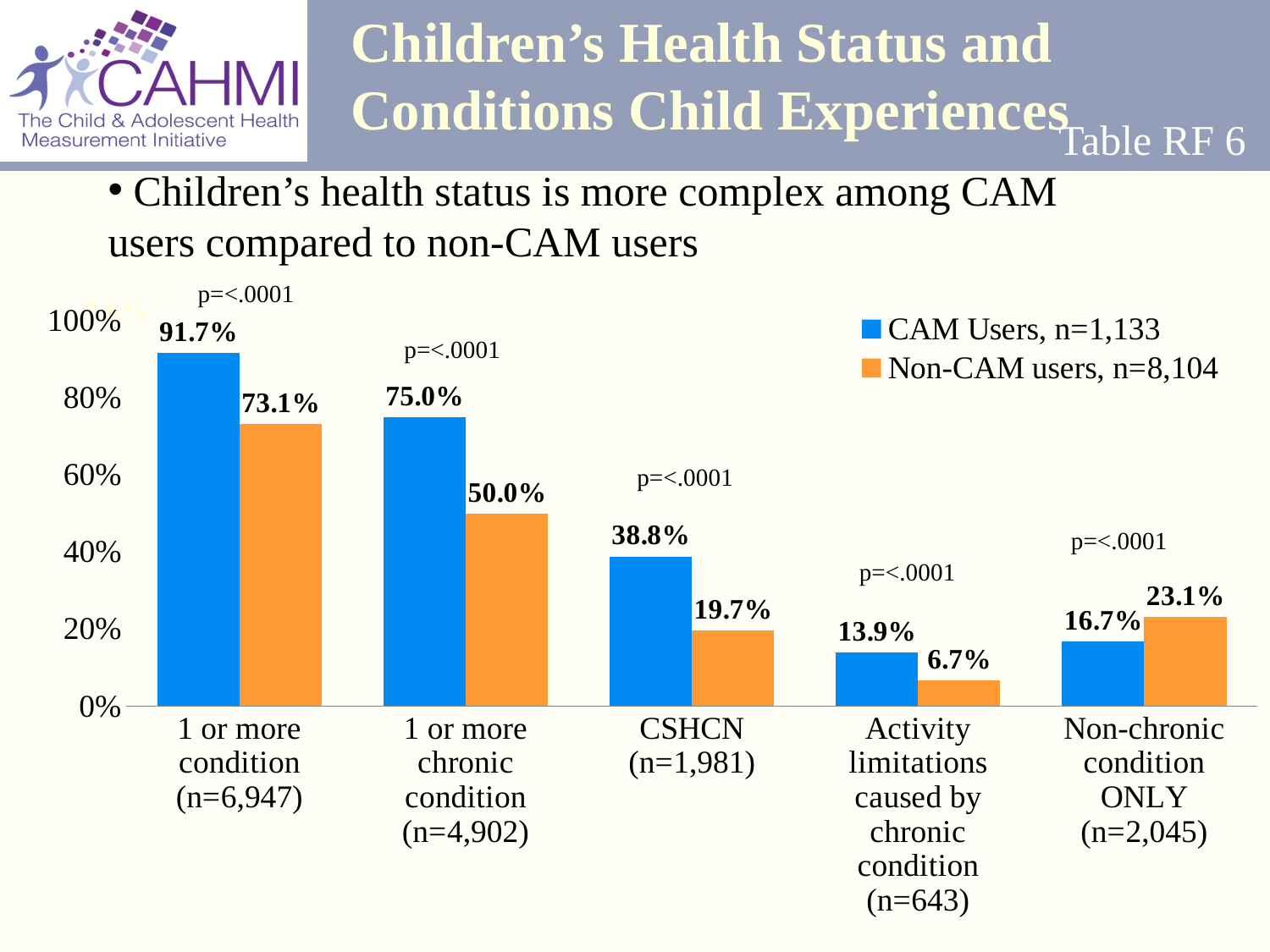
What kind of chart is shown on the slide? bar chart What is the value for CAM Users in the '1 or more condition (n=6,947)' category? 91.7% How many categories are shown on the x axis? 5 How many series does the legend list? 2 What is the value for Non-CAM users in the 'CSHCN (n=1,981)' category? 19.7% Which category has the highest value for CAM Users? 1 or more condition (n=6,947) What is the difference between CAM Users and Non-CAM users in the '1 or more chronic condition (n=4,902)' category? 25.0% In the 'Non-chronic condition ONLY (n=2,045)' category, which series has the larger value, CAM Users or Non-CAM users? Non-CAM users Is the value for CAM Users in the 'CSHCN (n=1,981)' category greater or less than 40%? less What is the value for Non-CAM users in the 'Non-chronic condition ONLY (n=2,045)' category? 23.1% Which category has the lowest value for Non-CAM users? Activity limitations caused by chronic condition (n=643) Which colour represents CAM Users in the chart? blue